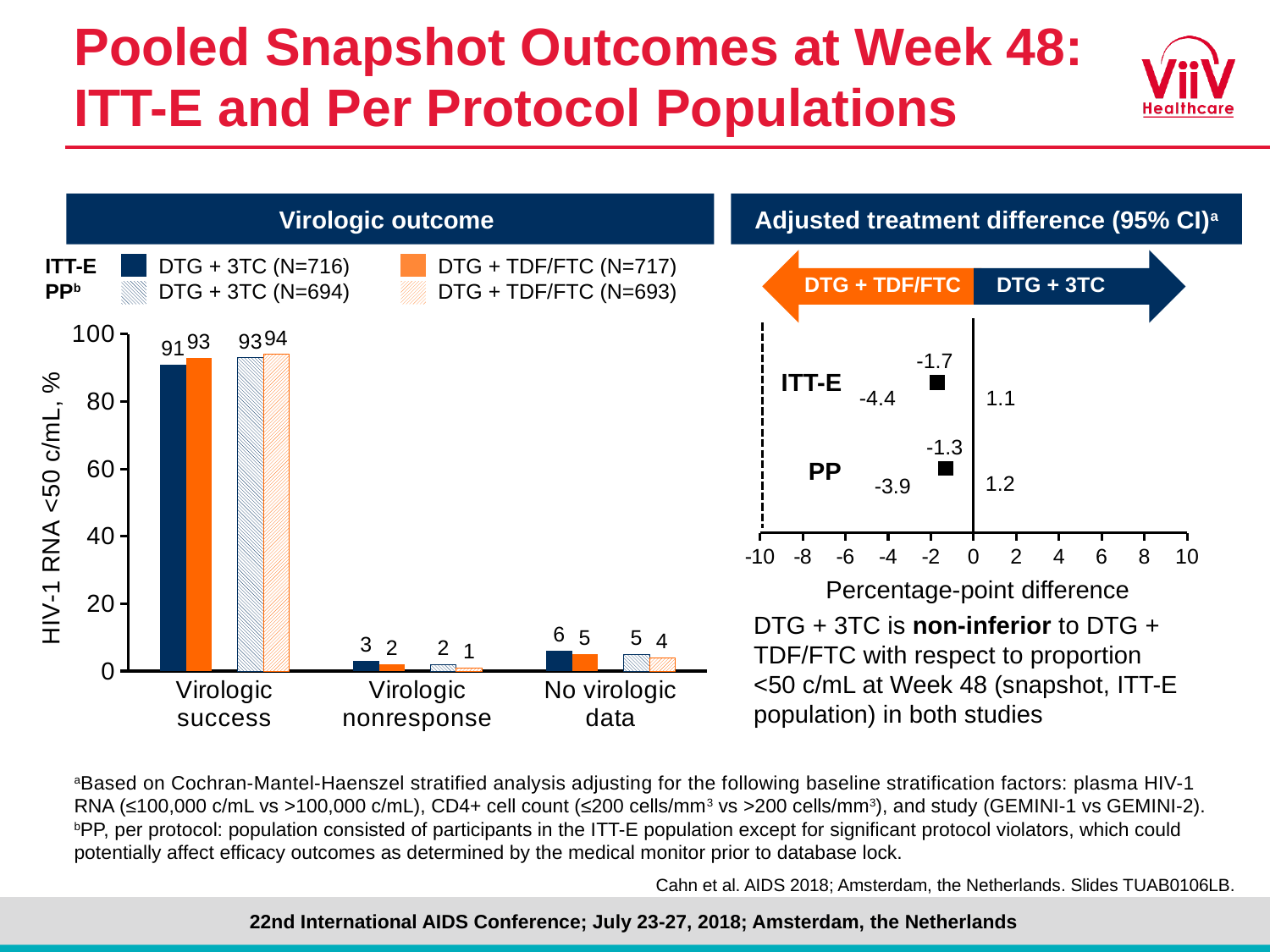
In the Virologic outcome chart, what is the value for DTG + 3TC (N=716) in the ITT-E population for Virologic success? 91 In the Adjusted treatment difference chart, what is the upper confidence limit for the PP population? 1.2 In the Virologic outcome chart, which category has the highest values? Virologic success In the Virologic outcome chart, what is the difference between the ITT-E DTG + TDF/FTC and ITT-E DTG + 3TC values for Virologic success? 2 In the Virologic outcome chart, what is the value for DTG + TDF/FTC (N=717) in the ITT-E population for Virologic success? 93 What kind of chart is the Virologic outcome chart? Bar chart In the Virologic outcome chart, what is the value for DTG + 3TC (N=716) in the ITT-E population for No virologic data? 6 In the Virologic outcome chart, what is the value for DTG + TDF/FTC (N=693) in the PP population for Virologic success? 94 In the Adjusted treatment difference chart, what is the point estimate for the ITT-E population? -1.7 In the Virologic outcome chart, how many series does the legend list? 4 In the Virologic outcome chart, what is the y-axis label? HIV-1 RNA <50 c/mL, % In the Virologic outcome chart, how many categories are shown on the x axis? 3